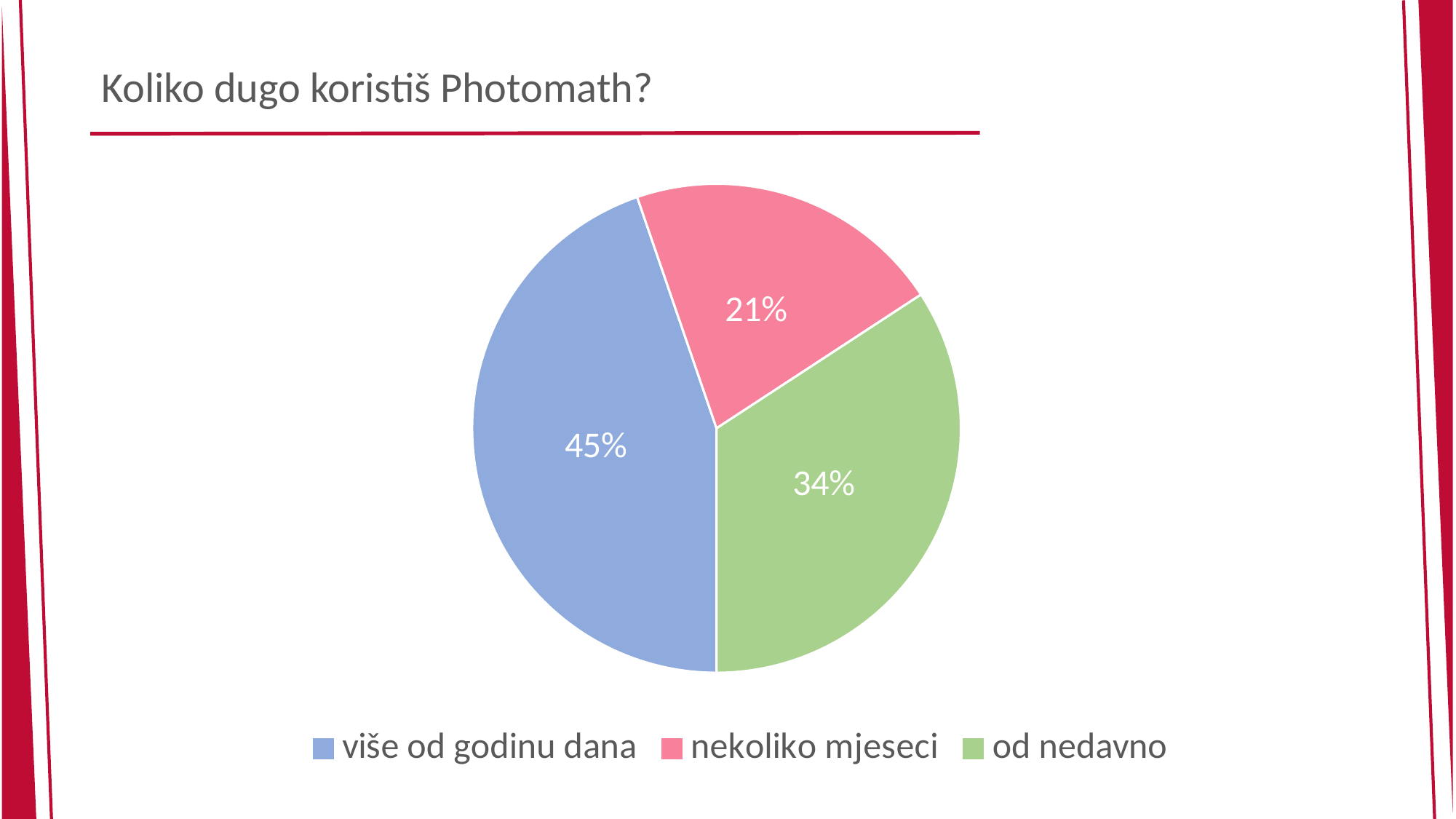
What share of the pie does 'više od godinu dana' take? 45% What colour is the slice for 'od nedavno'? green What is the difference between the shares for 'od nedavno' and 'nekoliko mjeseci'? 13% What is the title of the slide above the chart? Koliko dugo koristiš Photomath? What is the value shown for 'nekoliko mjeseci'? 21% How many categories does the pie chart show? 3 Which category has the smallest slice of the pie? nekoliko mjeseci What is the value shown for 'od nedavno'? 34% Which is larger, the share for 'od nedavno' or the share for 'nekoliko mjeseci'? od nedavno What kind of chart is shown on the slide? pie chart Which category has the largest slice of the pie? više od godinu dana What is the difference between the shares for 'više od godinu dana' and 'od nedavno'? 11%